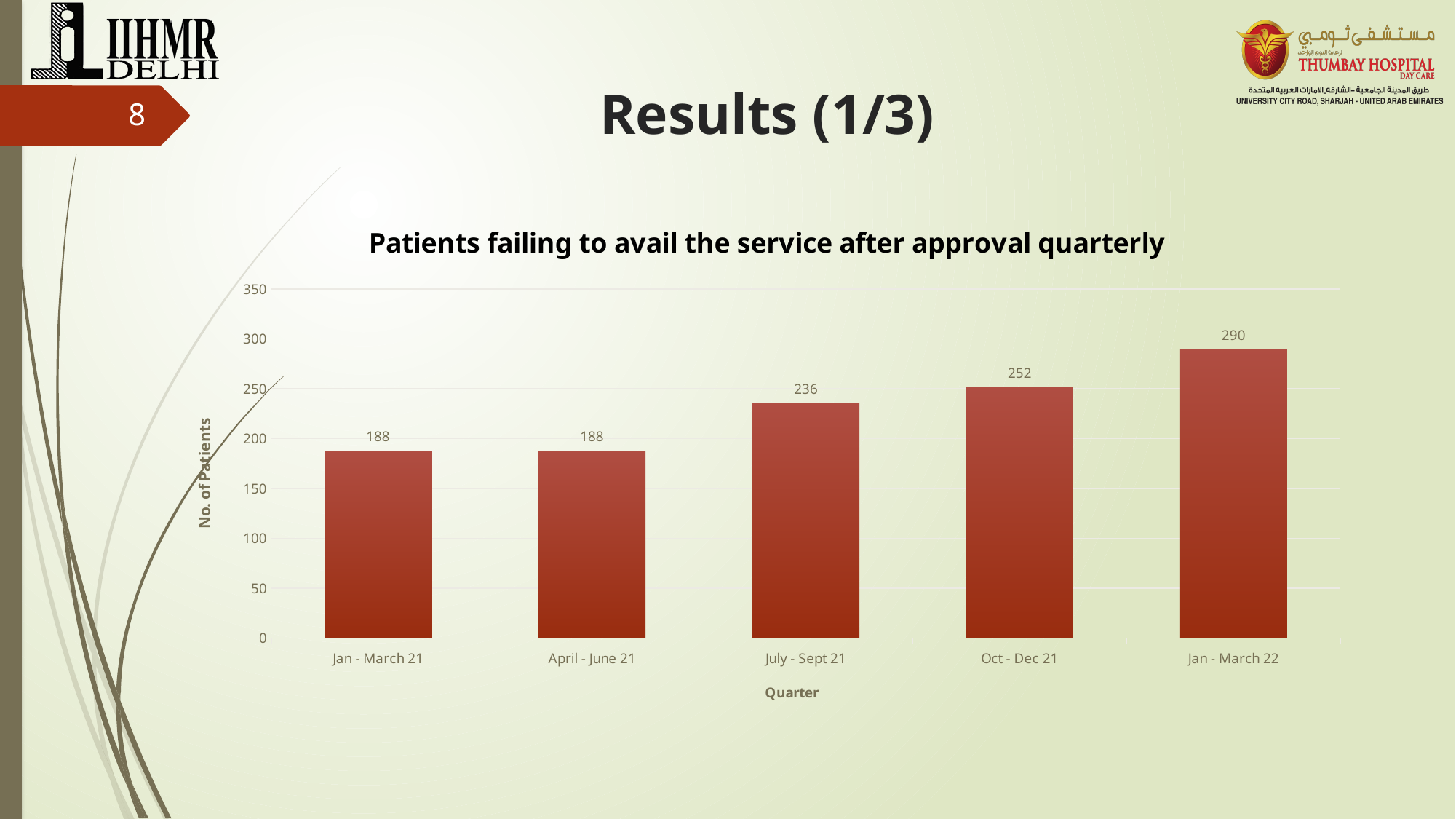
What is the difference between the values for Jan - March 22 and Oct - Dec 21? 38 What kind of chart is shown on the slide? bar chart Which is larger, the value for Oct - Dec 21 or the value for July - Sept 21? Oct - Dec 21 Do the values generally rise or fall from Jan - March 21 to Jan - March 22? rise What is the value for July - Sept 21? 236 Is the value for Jan - March 21 greater or less than 200? less What is the value for Jan - March 22? 290 How many quarters are shown on the chart? 5 What is the value for Oct - Dec 21? 252 What is the title of the chart? Patients failing to avail the service after approval quarterly What is the difference between the values for July - Sept 21 and April - June 21? 48 Which quarter has the highest number of patients? Jan - March 22